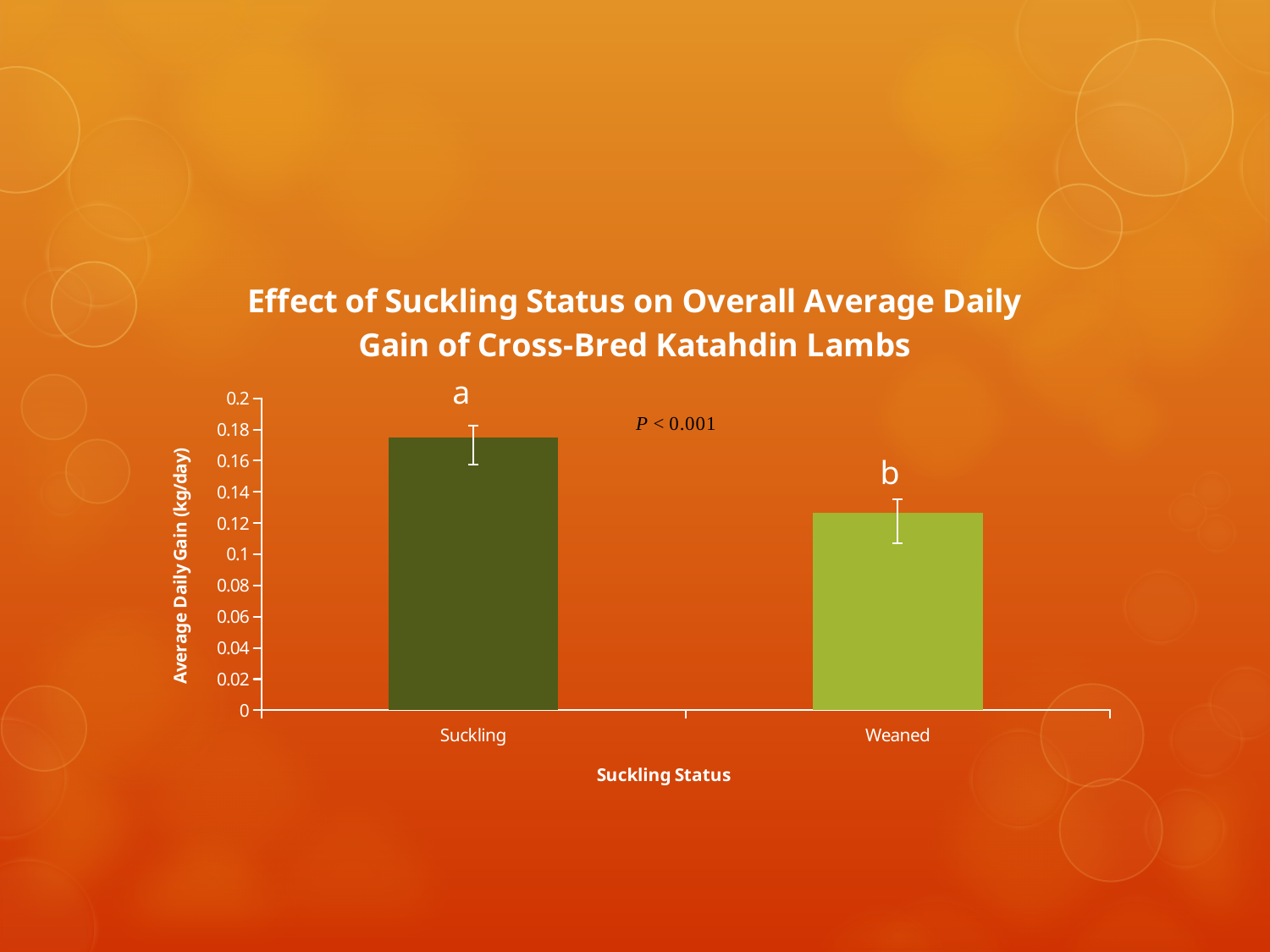
What is the label of the x axis? Suckling Status Which has a larger average daily gain, Suckling or Weaned? Suckling Which category has the highest average daily gain? Suckling Do the values rise or fall from Suckling to Weaned along the x axis? fall Is the value for Suckling greater or less than 0.16? greater Which category has the lowest average daily gain? Weaned What is the label of the y axis? Average Daily Gain (kg/day) How many categories are plotted on the x axis? 2 Is the value for Weaned greater or less than 0.14? less What is the title of the chart? Effect of Suckling Status on Overall Average Daily Gain of Cross-Bred Katahdin Lambs What type of chart is shown on the slide? bar chart Is the value for Weaned greater or less than 0.1? greater